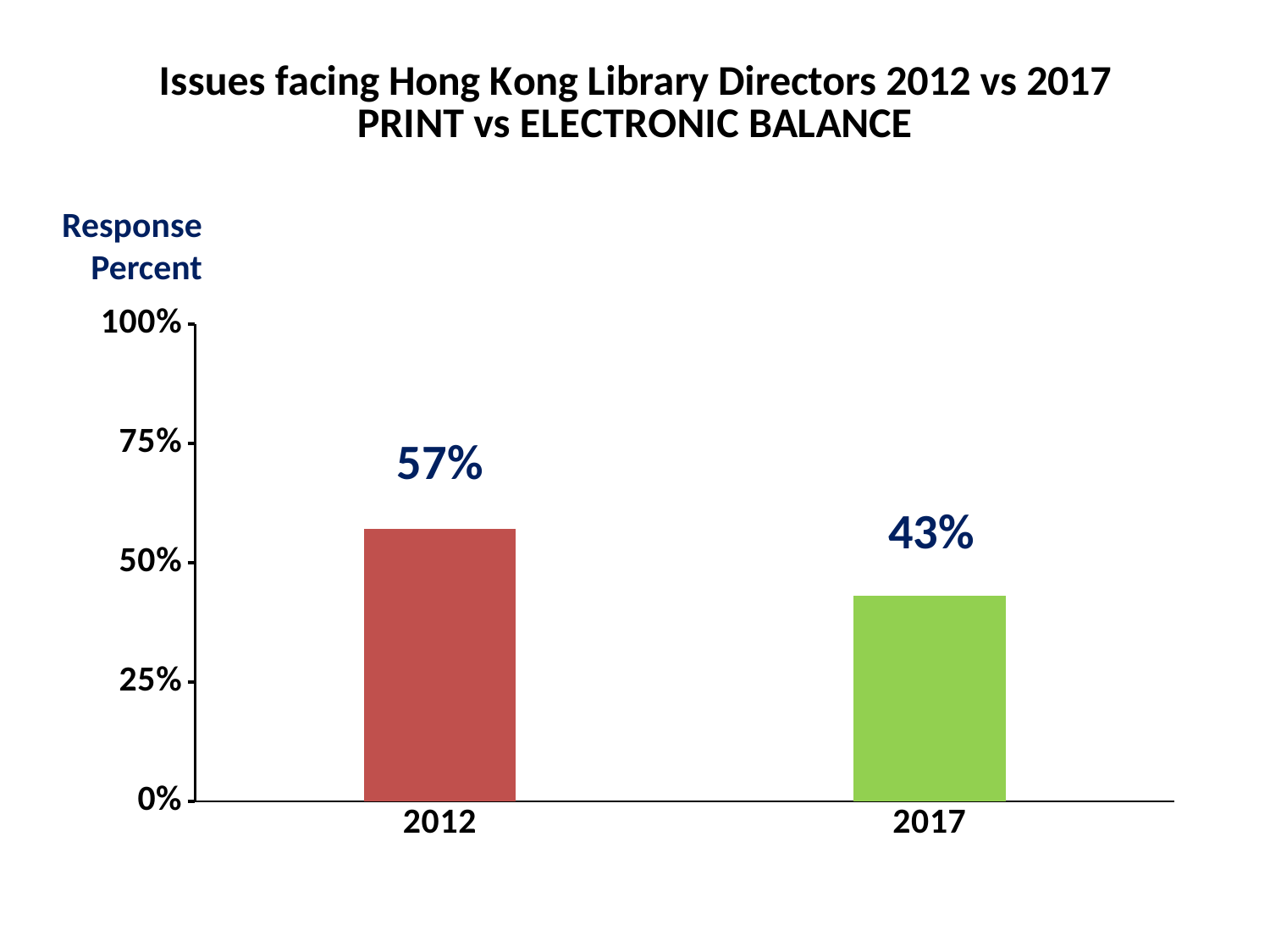
Is the response percent for 2012 larger or smaller than for 2017? larger Which year has the higher response percent? 2012 What is the difference between the 2012 and 2017 response percents? 14% Is the value for 2012 greater or less than 50%? greater Is the value for 2017 greater or less than 50%? less How many years are shown on the x axis? 2 Does the response percent rise or fall from 2012 to 2017? fall What kind of chart is shown on the slide? bar chart Which year has the lower response percent? 2017 What is the response percent for 2012? 57% What is the response percent for 2017? 43% What is the label of the y axis? Response Percent